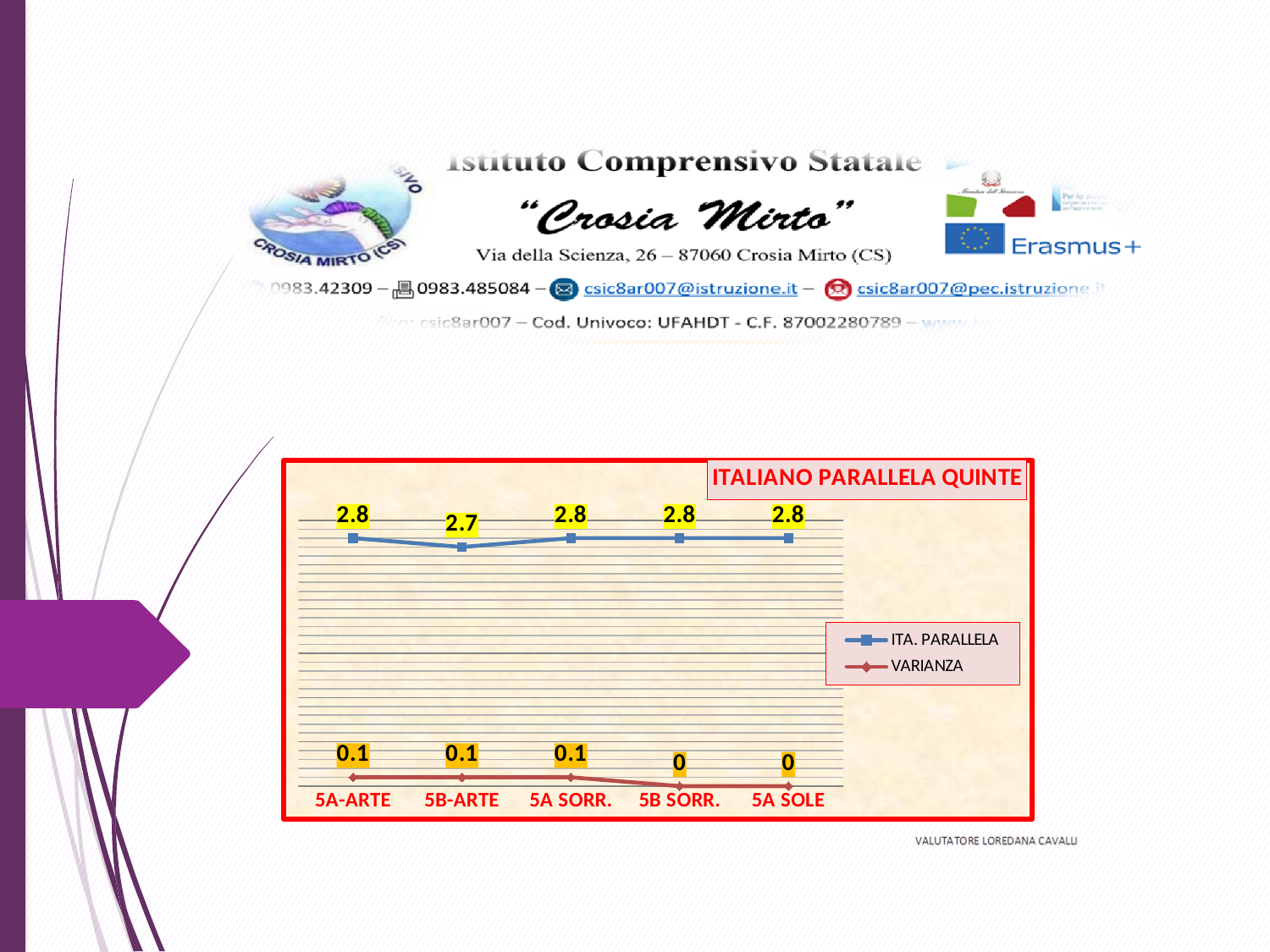
Which is larger, the ITA. PARALLELA value for 5A SORR. or for 5B-ARTE? 5A SORR. What is the ITA. PARALLELA value for 5A SOLE? 2.8 How many categories are shown on the x axis? 5 Which series is drawn in blue? ITA. PARALLELA What is the VARIANZA value for 5B SORR.? 0 What kind of chart is shown on the slide? line chart How many series does the legend list? 2 Which category has the lowest ITA. PARALLELA value? 5B-ARTE What is the VARIANZA value for 5A SORR.? 0.1 What is the ITA. PARALLELA value for 5B-ARTE? 2.7 What is the difference between the ITA. PARALLELA values for 5A-ARTE and 5B-ARTE? 0.1 What is the title of the chart? ITALIANO PARALLELA QUINTE